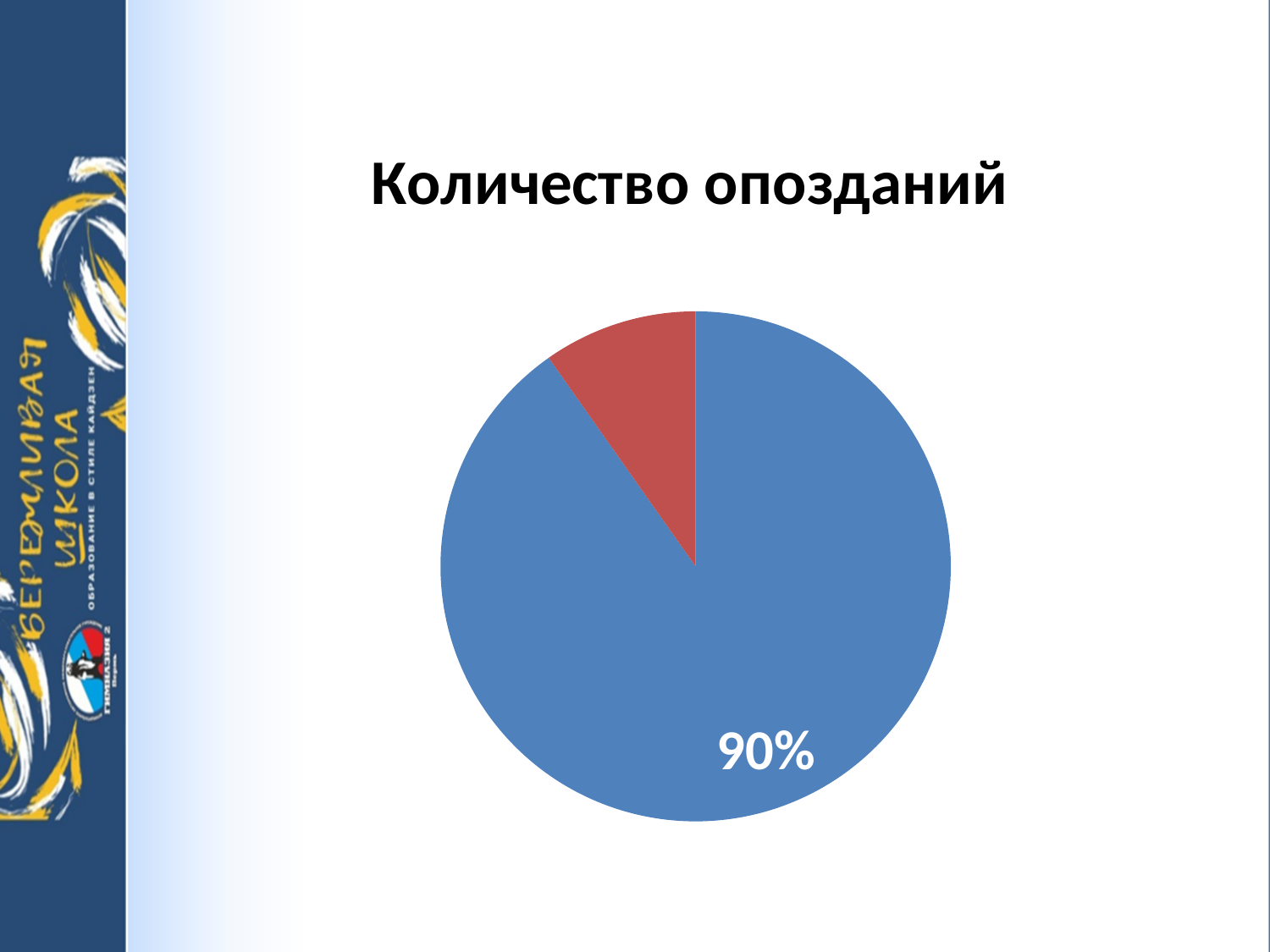
Is the red slice's share greater or less than 50%? less How many slices does the pie chart have? 2 What percentage is printed on the blue slice of the pie chart? 90% What kind of chart is shown on the slide? pie chart Which slice of the pie chart is the largest? the blue slice Which slice of the pie chart is the smallest? the red slice What share of the pie does the red slice represent? 10% What is the title of the chart? Количество опозданий Which slice is larger, the blue one or the red one? the blue one What colour is the slice labelled 90%? blue Is the blue slice's share greater or less than 50%? greater